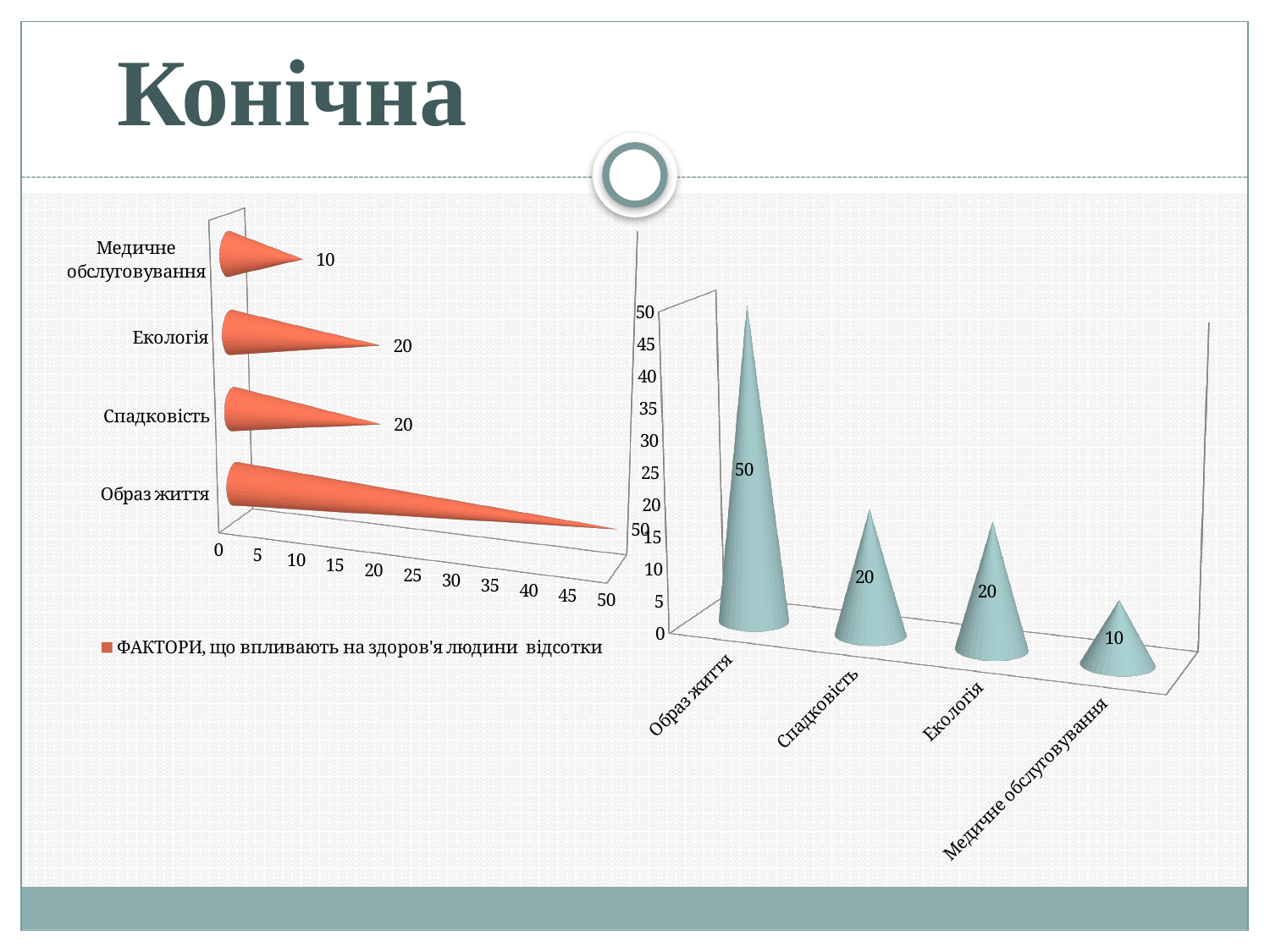
In the left chart, which is larger: the value for Екологія or the value for Медичне обслуговування? Екологія In the right chart, what is the difference between the values for Образ життя and Спадковість? 30 In the right chart, do the values rise or fall from left to right along the x axis? Fall How many categories are shown in the right chart? 4 How many series does the legend of the left chart list? 1 In the right chart, what is the value for Екологія? 20 In the left chart, which category has the lowest value? Медичне обслуговування What kind of chart is the left chart? Bar chart What is the legend entry shown below the left chart? ФАКТОРИ, що впливають на здоров'я людини відсотки In the right chart, which category has the highest value? Образ життя In the left chart, what is the value for Медичне обслуговування? 10 In the left chart, what is the value for Образ життя? 50